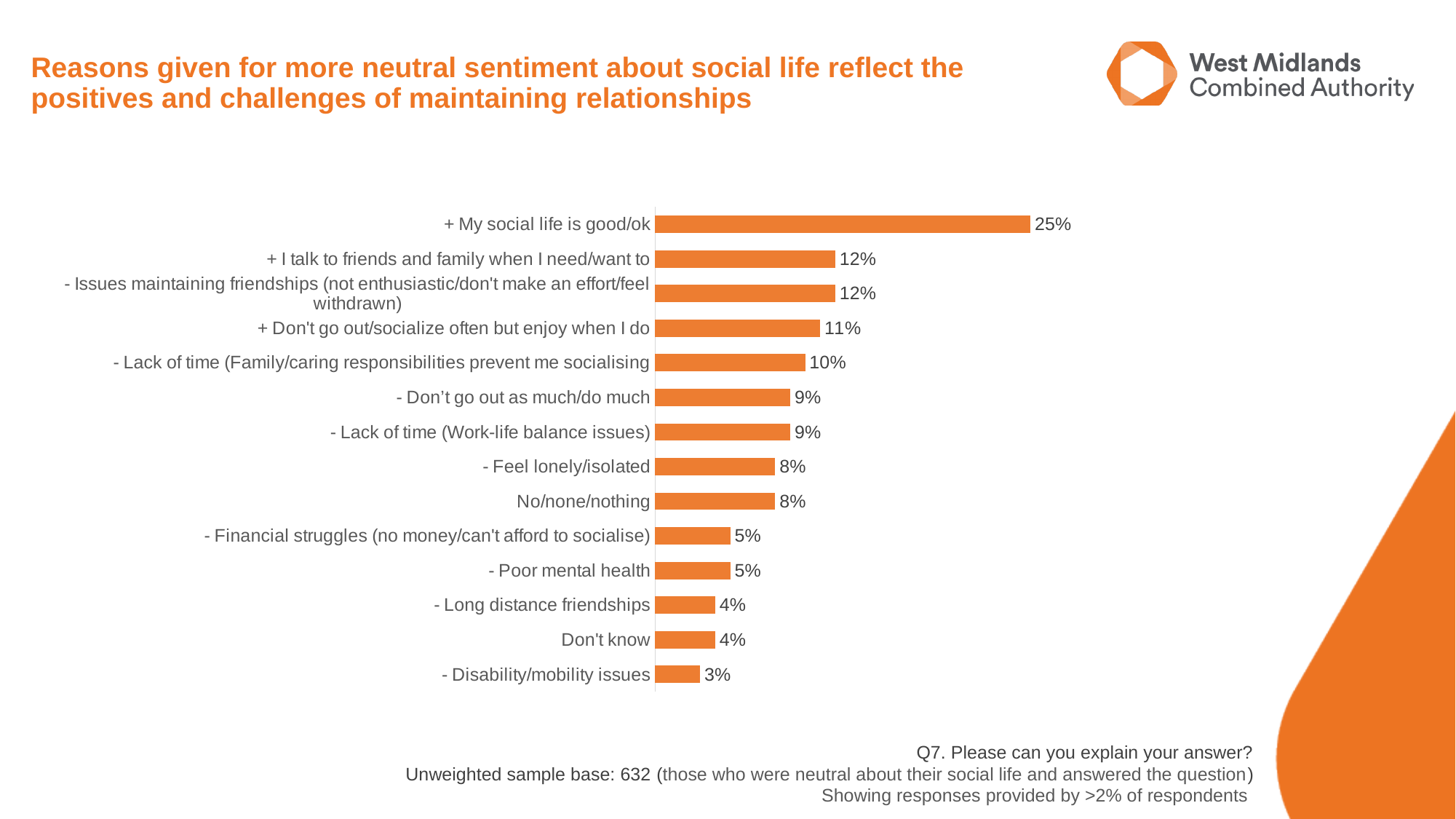
How many reasons (bars) are shown in the chart? 14 What percentage is shown for "Disability/mobility issues"? 3% What is the difference between "My social life is good/ok" and "I talk to friends and family when I need/want to"? 13 percentage points Which is larger: "Don't go out/socialize often but enjoy when I do" or "Poor mental health"? Don't go out/socialize often but enjoy when I do What kind of chart is shown on the slide? Bar chart What is the value for "Feel lonely/isolated"? 8% Which reason has the highest percentage? My social life is good/ok What is the unweighted sample base stated on the slide? 632 What is the difference between "Financial struggles (no money/can't afford to socialise)" and "Long distance friendships"? 1 percentage point Which reason has the lowest percentage? Disability/mobility issues What is the value for "Lack of time (Family/caring responsibilities prevent me socialising"? 10% What percentage of respondents gave "My social life is good/ok" as a reason? 25%